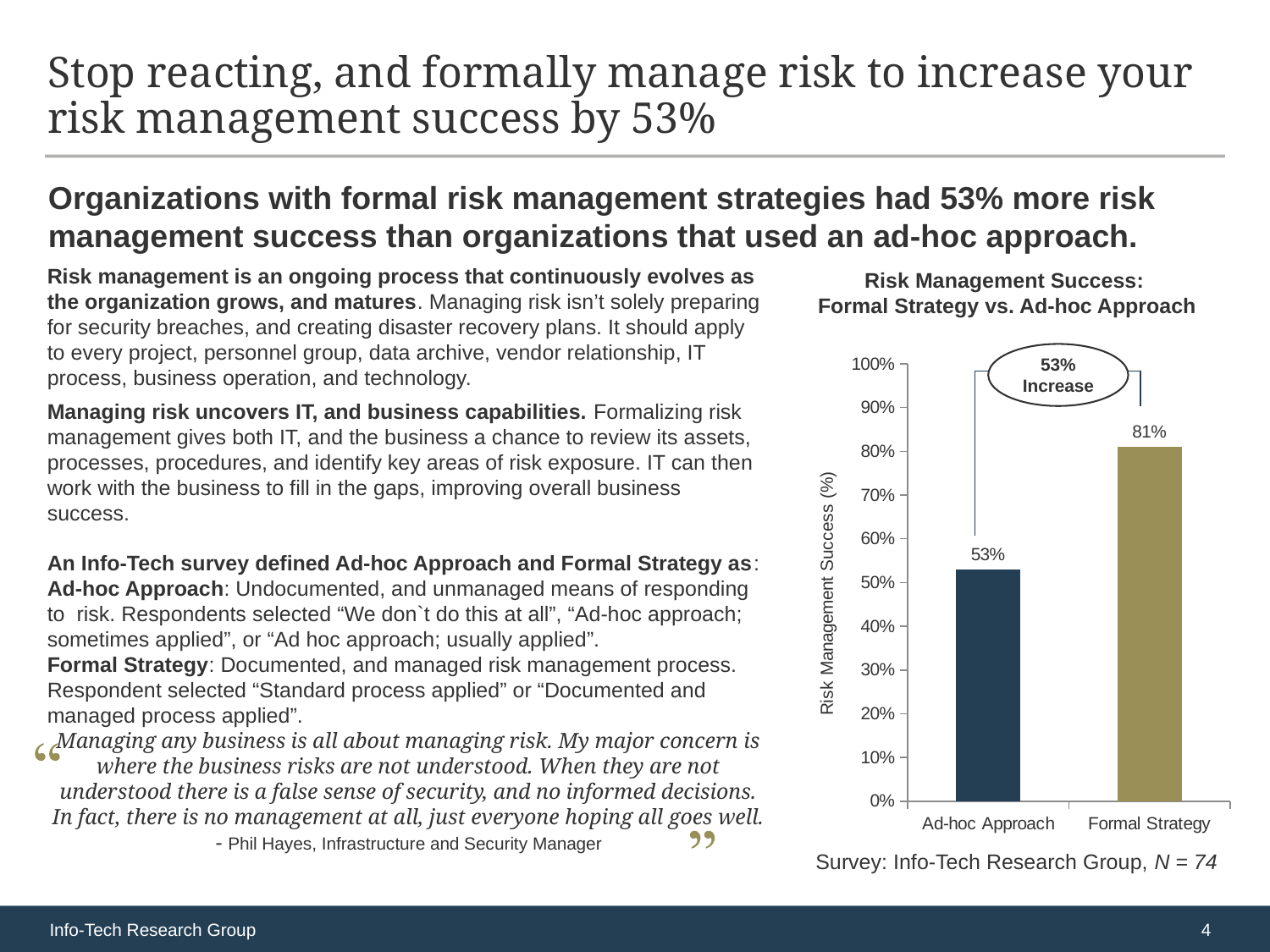
What kind of chart is shown on the slide? Bar chart Which is larger, the value for Ad-hoc Approach or the value for Formal Strategy? Formal Strategy Which category has the highest Risk Management Success? Formal Strategy What is the title of the chart? Risk Management Success: Formal Strategy vs. Ad-hoc Approach What is the label on the y axis of the chart? Risk Management Success (%) Which category has the lowest Risk Management Success? Ad-hoc Approach What is the Risk Management Success value for Ad-hoc Approach? 53% What is the difference in Risk Management Success between Formal Strategy and Ad-hoc Approach? 28% Is the value for Ad-hoc Approach greater or less than 60%? less What is the Risk Management Success value for Formal Strategy? 81% How many categories are shown on the x axis of the chart? 2 Is the value for Formal Strategy greater or less than 70%? greater